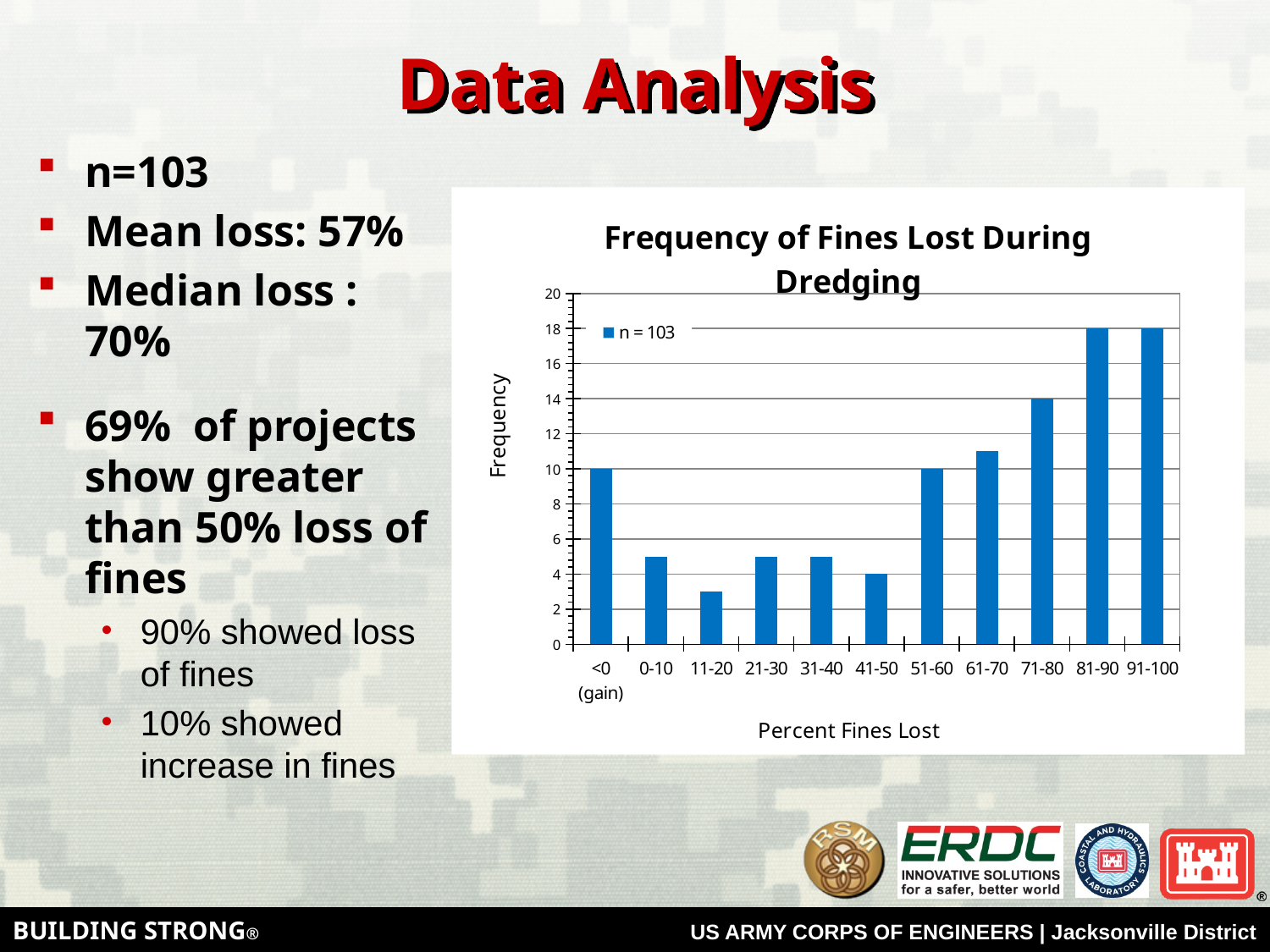
Is the frequency for the 0-10 category greater or less than 6? less How many categories are shown on the x axis of the chart? 11 What is the title of the chart? Frequency of Fines Lost During Dredging Which category has the lowest frequency? 11-20 Which has a higher frequency, the 51-60 category or the 31-40 category? 51-60 What kind of chart is shown on the slide? bar chart Is the frequency for the 61-70 category greater or less than 10? greater What is the frequency for the 71-80 percent fines lost category? 14 What is the label on the y axis of the chart? Frequency What is the frequency for the 41-50 category? 4 What is the frequency for the 81-90 category? 18 What is the frequency for the <0 (gain) category? 10